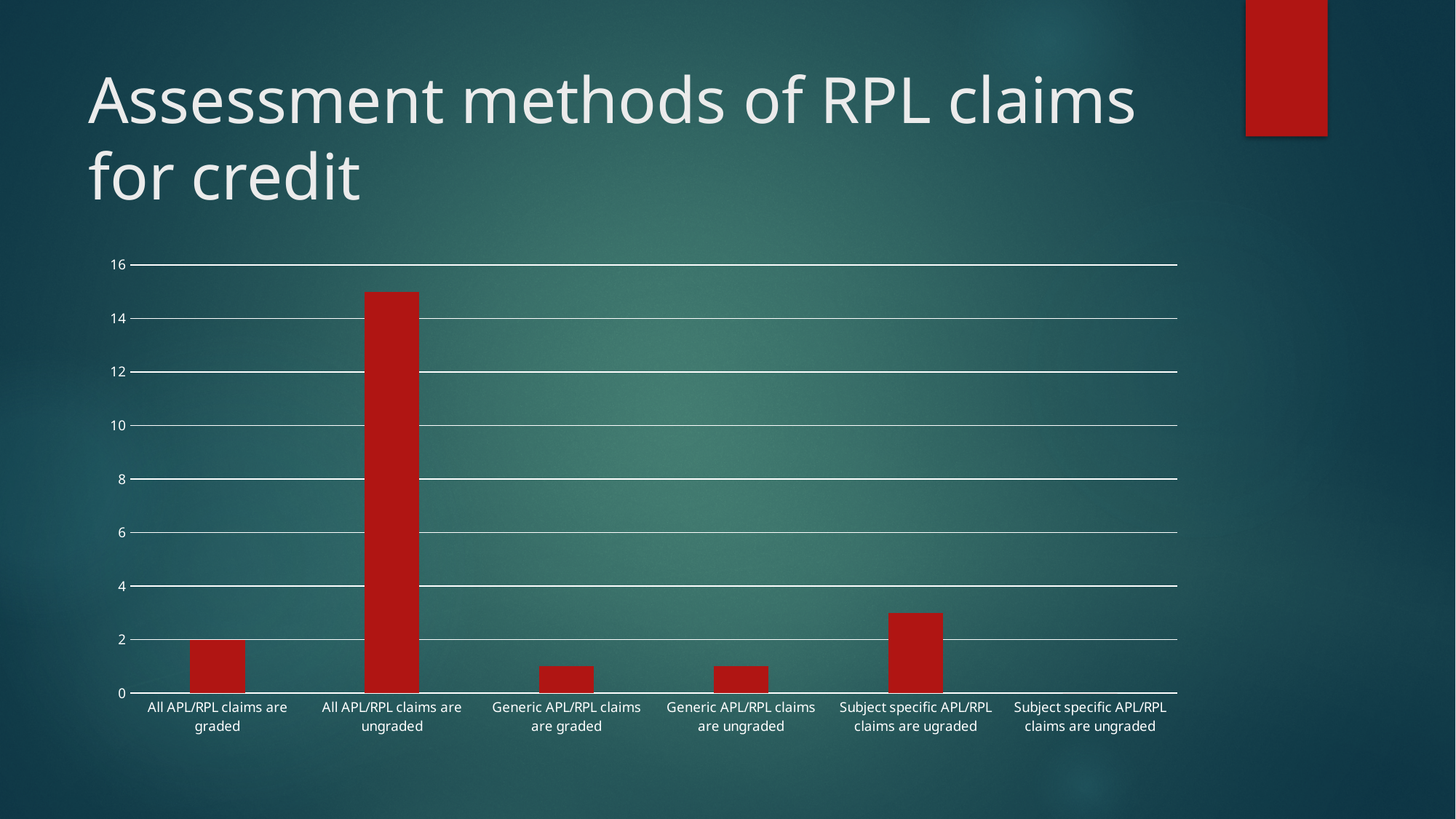
What is the value for 'Subject specific APL/RPL claims are ungraded'? 0 Which category has the highest value in the chart? All APL/RPL claims are ungraded How many categories are shown on the x axis of the chart? 6 What is the title of the slide containing the chart? Assessment methods of RPL claims for credit Is the value for 'All APL/RPL claims are ungraded' greater or less than 14? greater Which is larger: the value for 'All APL/RPL claims are ungraded' or the value for 'Subject specific APL/RPL claims are ugraded'? All APL/RPL claims are ungraded What is the value for 'All APL/RPL claims are graded'? 2 Which category has the lowest value in the chart? Subject specific APL/RPL claims are ungraded Which is larger: the value for 'All APL/RPL claims are graded' or the value for 'Generic APL/RPL claims are ungraded'? All APL/RPL claims are graded What kind of chart is shown on the slide? bar chart Is the value for 'Generic APL/RPL claims are graded' greater or less than 2? less Is the value for 'Subject specific APL/RPL claims are ugraded' greater or less than 4? less